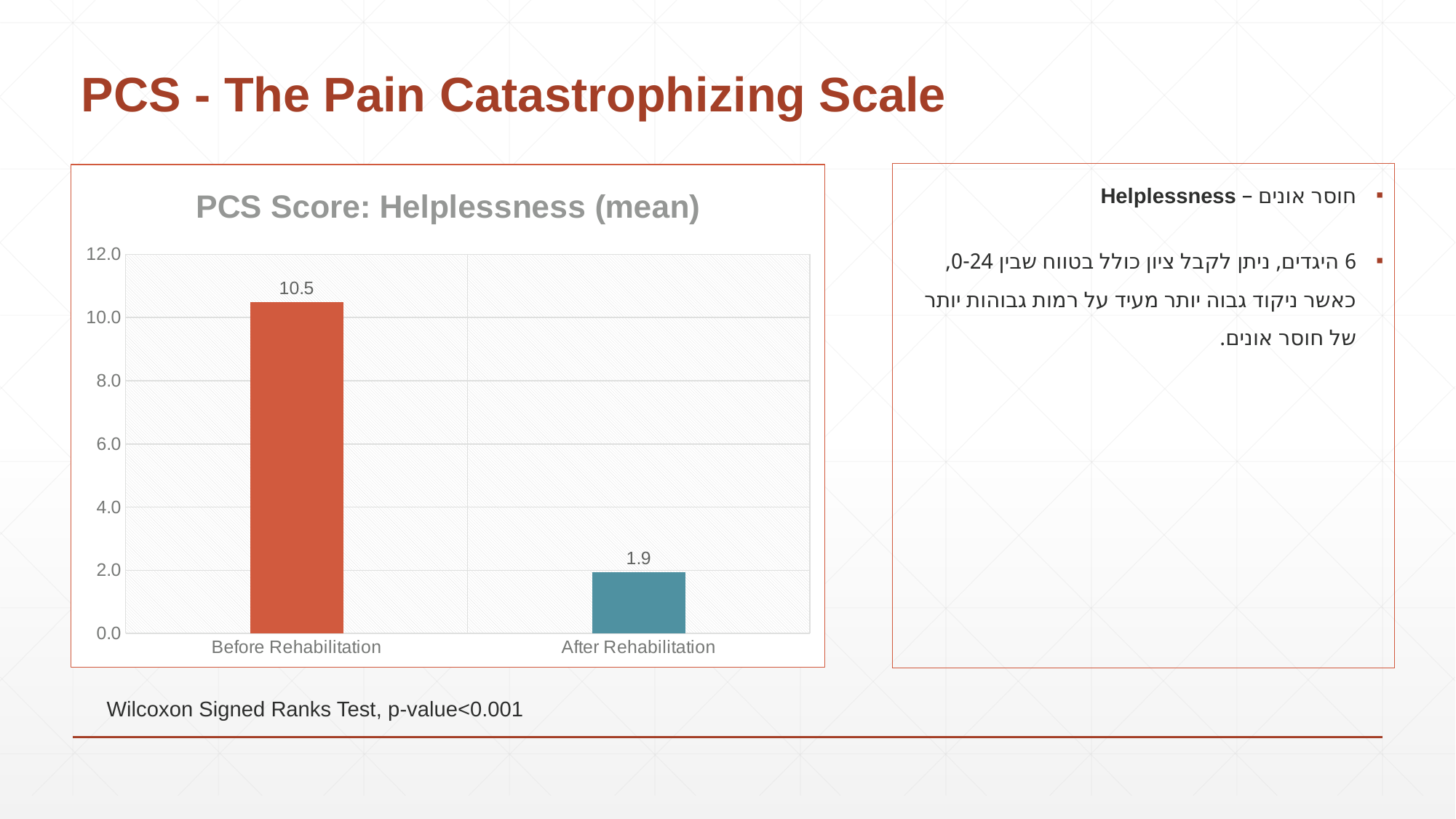
Is the value for Before Rehabilitation greater or less than 10.0? greater Is the value for After Rehabilitation greater or less than 2.0? less What is the mean PCS Helplessness score before rehabilitation? 10.5 What is the title of the chart? PCS Score: Helplessness (mean) Do the values rise or fall from Before Rehabilitation to After Rehabilitation? Fall By how much does the mean Helplessness score differ between before and after rehabilitation? 8.6 Which category has the higher mean Helplessness score? Before Rehabilitation What is the mean PCS Helplessness score after rehabilitation? 1.9 Which category has the lower mean Helplessness score? After Rehabilitation How many categories are shown on the x axis of the chart? 2 What kind of chart is shown on the slide? Bar chart Is the mean Helplessness score larger before or after rehabilitation? Before Rehabilitation